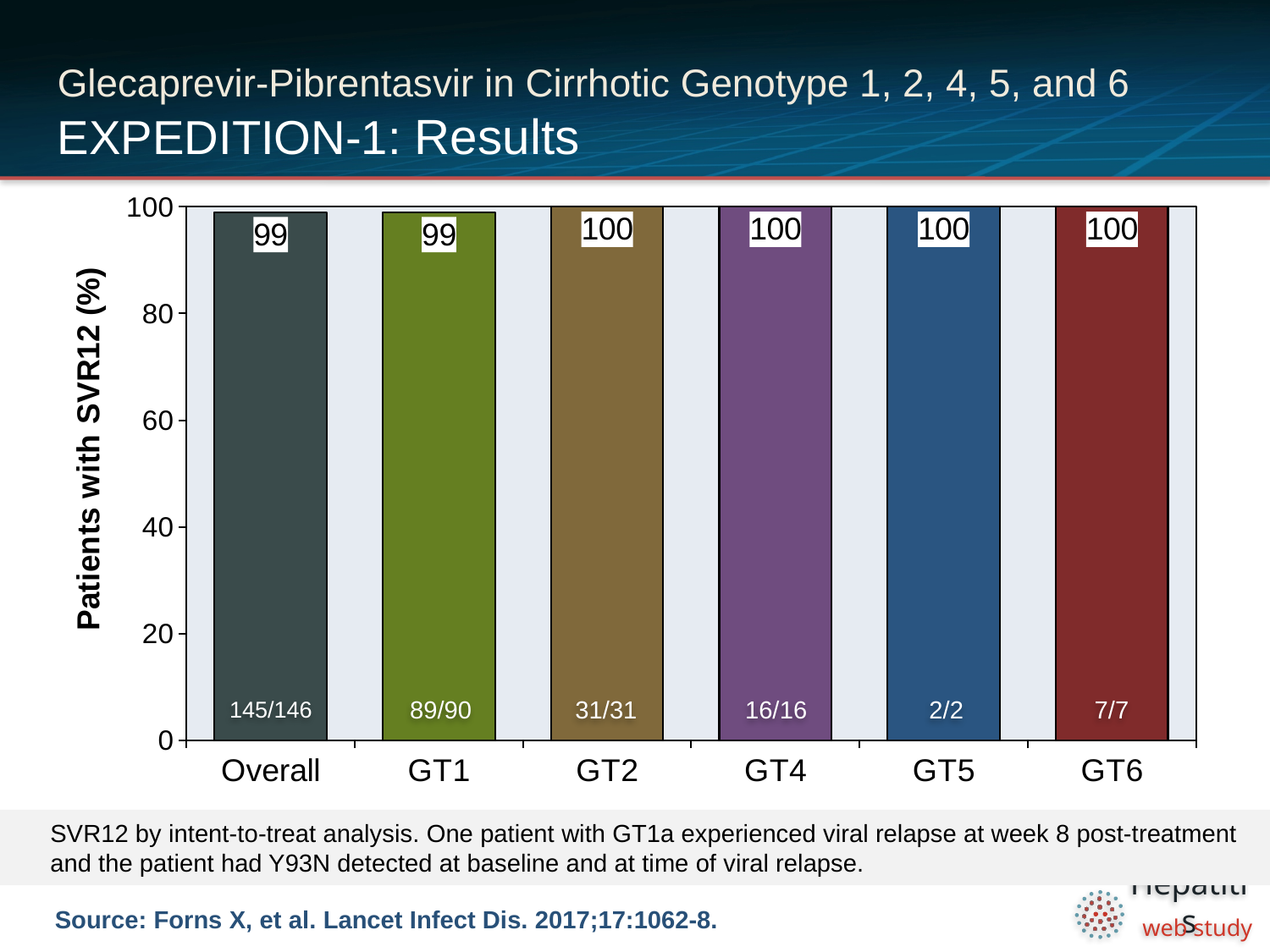
What is the SVR12 rate for the Overall group? 99 Which is larger, the SVR12 rate for GT6 or the SVR12 rate for Overall? GT6 What is the SVR12 rate for GT1? 99 What is the SVR12 rate for GT4? 100 What is the label of the y axis? Patients with SVR12 (%) What fraction of patients is shown inside the Overall bar? 145/146 How many categories are shown on the x axis? 6 What kind of chart is shown on the slide? bar chart What is the difference between the SVR12 rate for GT2 and the SVR12 rate for GT1? 1 Is the SVR12 rate for GT1 greater or less than 80? greater What fraction of patients is shown inside the GT5 bar? 2/2 What fraction of patients is shown inside the GT2 bar? 31/31